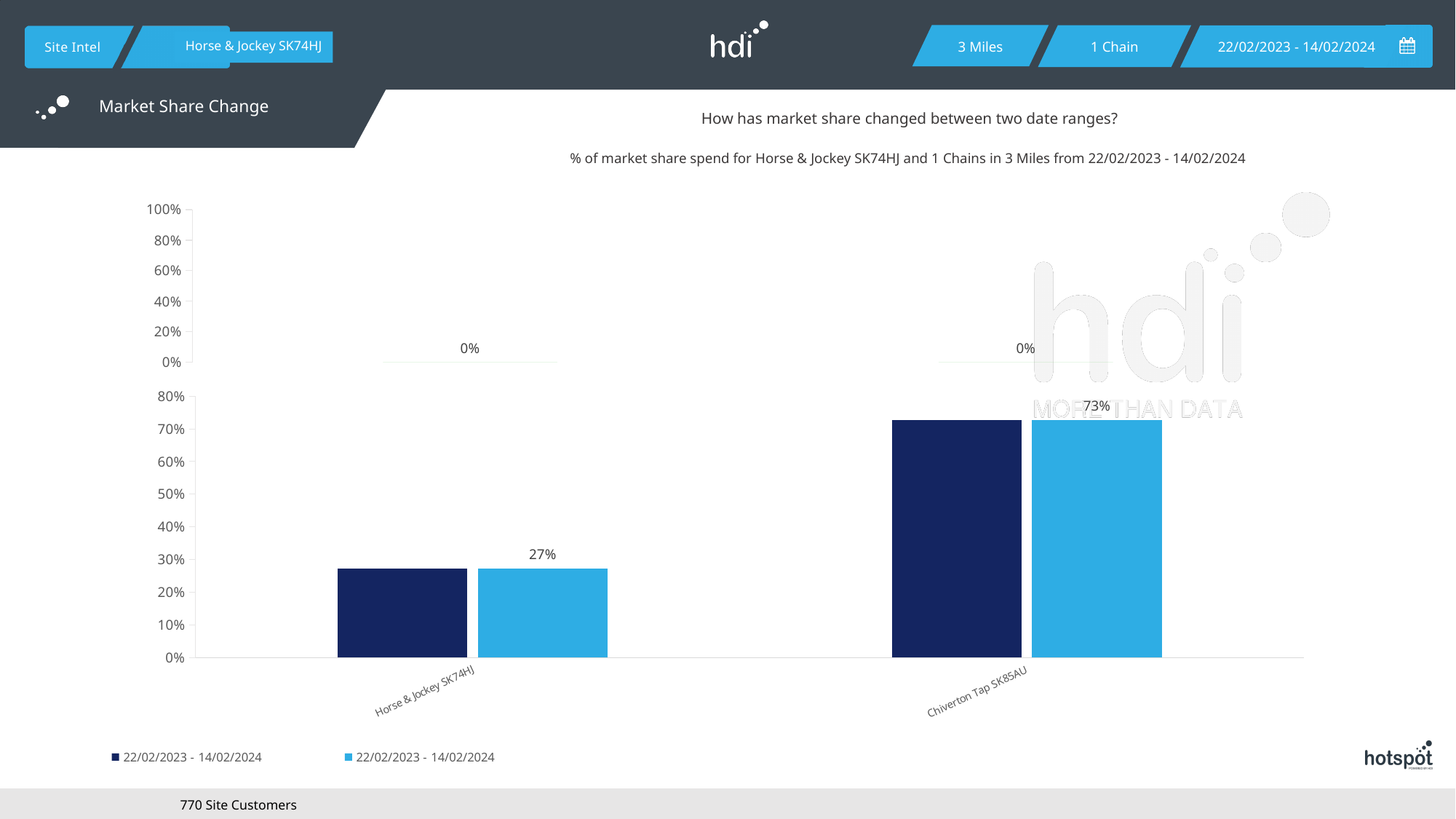
On the bottom bar chart, which category has the lowest market share? Horse & Jockey SK74HJ On the bottom bar chart, is the value for Chiverton Tap SK85AU greater or less than 60%? greater On the bottom bar chart, what is the market share value shown for Horse & Jockey SK74HJ? 27% On the bottom bar chart, what is the difference between the labelled values for Chiverton Tap SK85AU and Horse & Jockey SK74HJ? 46% How many series does the legend of the bottom bar chart list? 2 What is the title shown in the top-left panel of the slide? Market Share Change On the bottom bar chart, which category has the highest market share? Chiverton Tap SK85AU How many categories are shown on the x axis of the bottom bar chart? 2 On the bottom bar chart, what is the market share value shown for Chiverton Tap SK85AU? 73% On the top chart, what value is labelled for Horse & Jockey SK74HJ? 0% On the bottom bar chart, is the value for Horse & Jockey SK74HJ greater or less than 50%? less What type of chart is the bottom chart on the slide? bar chart